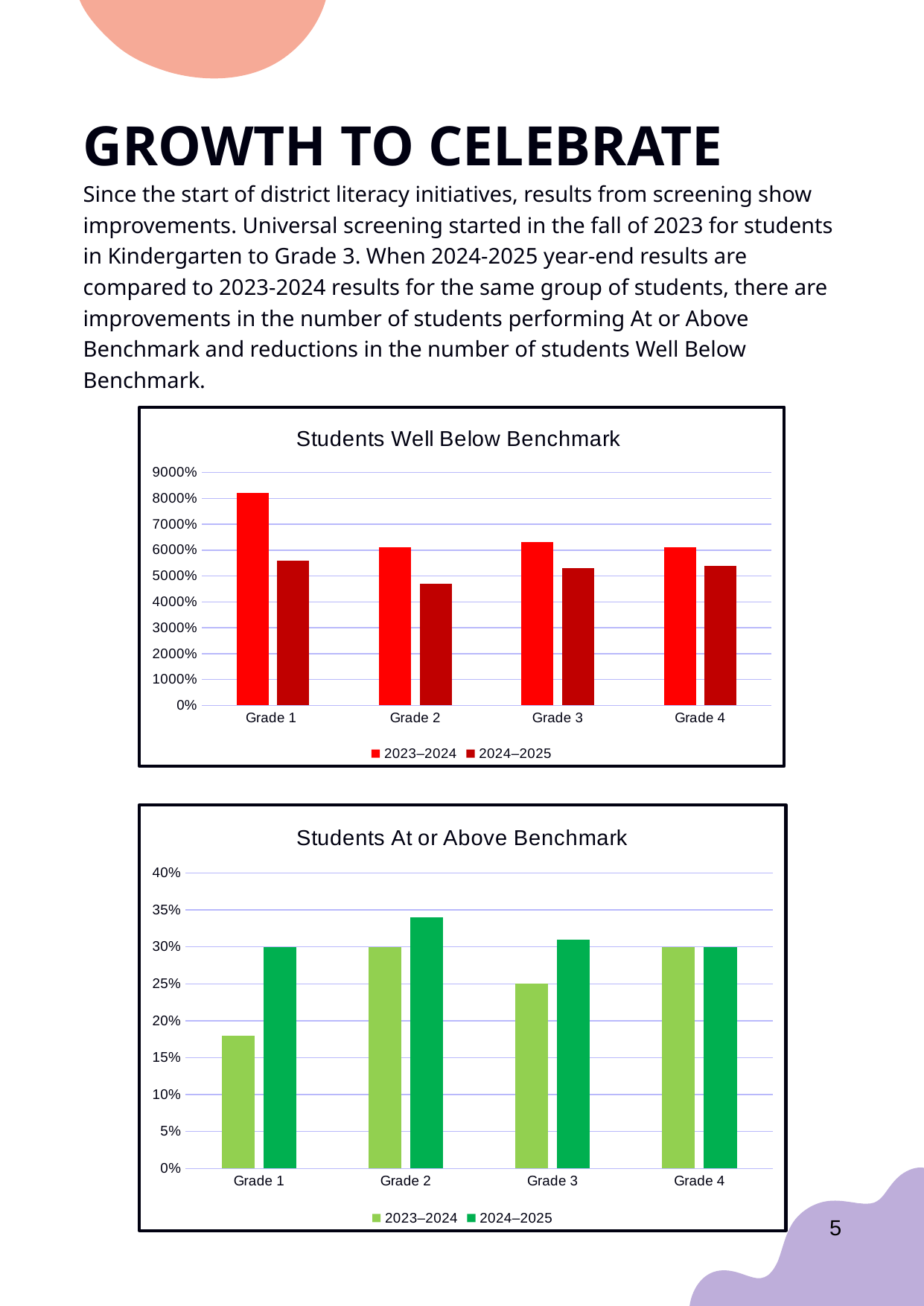
What are the two legend entries in the "Students At or Above Benchmark" chart? 2023–2024 and 2024–2025 In the "Students Well Below Benchmark" chart, which grade has the highest 2023–2024 value? Grade 1 In the "Students At or Above Benchmark" chart, what is the 2023–2024 value for Grade 3? 25% In the "Students Well Below Benchmark" chart, which series has the larger value for Grade 1, 2023–2024 or 2024–2025? 2023–2024 In the "Students Well Below Benchmark" chart, is the 2023–2024 value for Grade 1 greater or less than 8000%? greater In the "Students At or Above Benchmark" chart, which grade has the highest 2024–2025 value? Grade 2 How many series does the legend of the "Students Well Below Benchmark" chart list? 2 In the "Students At or Above Benchmark" chart, which grade has the lowest 2023–2024 value? Grade 1 How many grade categories are shown on the x axis of the "Students Well Below Benchmark" chart? 4 In the "Students Well Below Benchmark" chart, is the 2024–2025 value for Grade 2 greater or less than 5000%? less In the "Students At or Above Benchmark" chart, what is the 2024–2025 value for Grade 4? 30% What kind of chart is the "Students Well Below Benchmark" chart? Bar chart